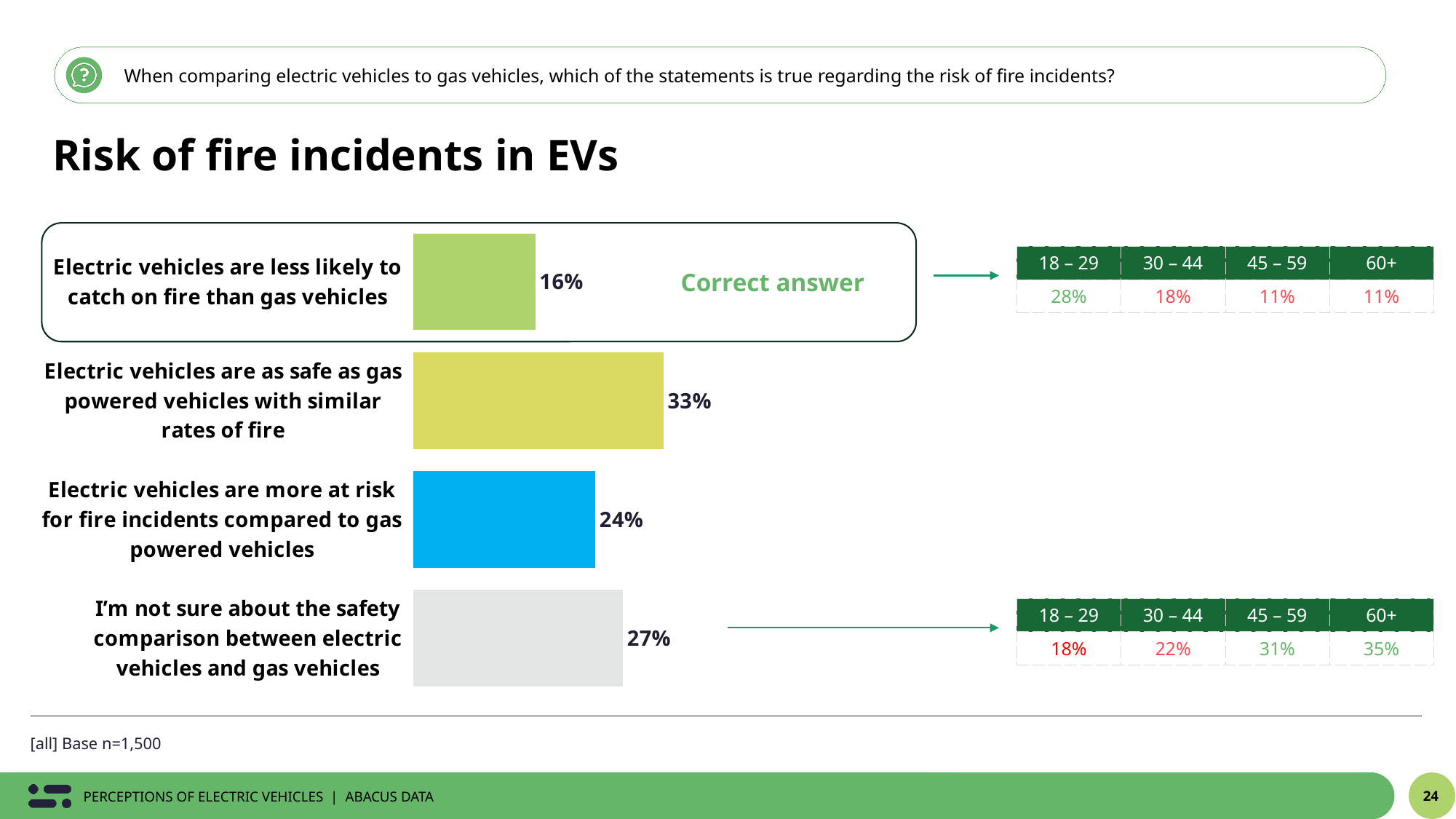
Which statement received the highest share of responses? Electric vehicles are as safe as gas powered vehicles with similar rates of fire Which statement is marked as the correct answer? Electric vehicles are less likely to catch on fire than gas vehicles What percentage of respondents said they are not sure about the safety comparison between electric vehicles and gas vehicles? 27% What percentage of respondents said electric vehicles are less likely to catch on fire than gas vehicles? 16% What percentage of respondents said electric vehicles are as safe as gas powered vehicles with similar rates of fire? 33% What is the difference in percentage points between the 'as safe as gas powered vehicles' response and the 'less likely to catch on fire' response? 17 What is the base sample size noted on the slide? n=1,500 Which statement received the lowest share of responses? Electric vehicles are less likely to catch on fire than gas vehicles How many statements (bars) are shown in the chart? 4 What percentage of respondents said electric vehicles are more at risk for fire incidents compared to gas powered vehicles? 24% Which received a larger share: 'more at risk for fire incidents' or 'not sure about the safety comparison'? I'm not sure about the safety comparison between electric vehicles and gas vehicles What type of chart is used on this slide? Bar chart